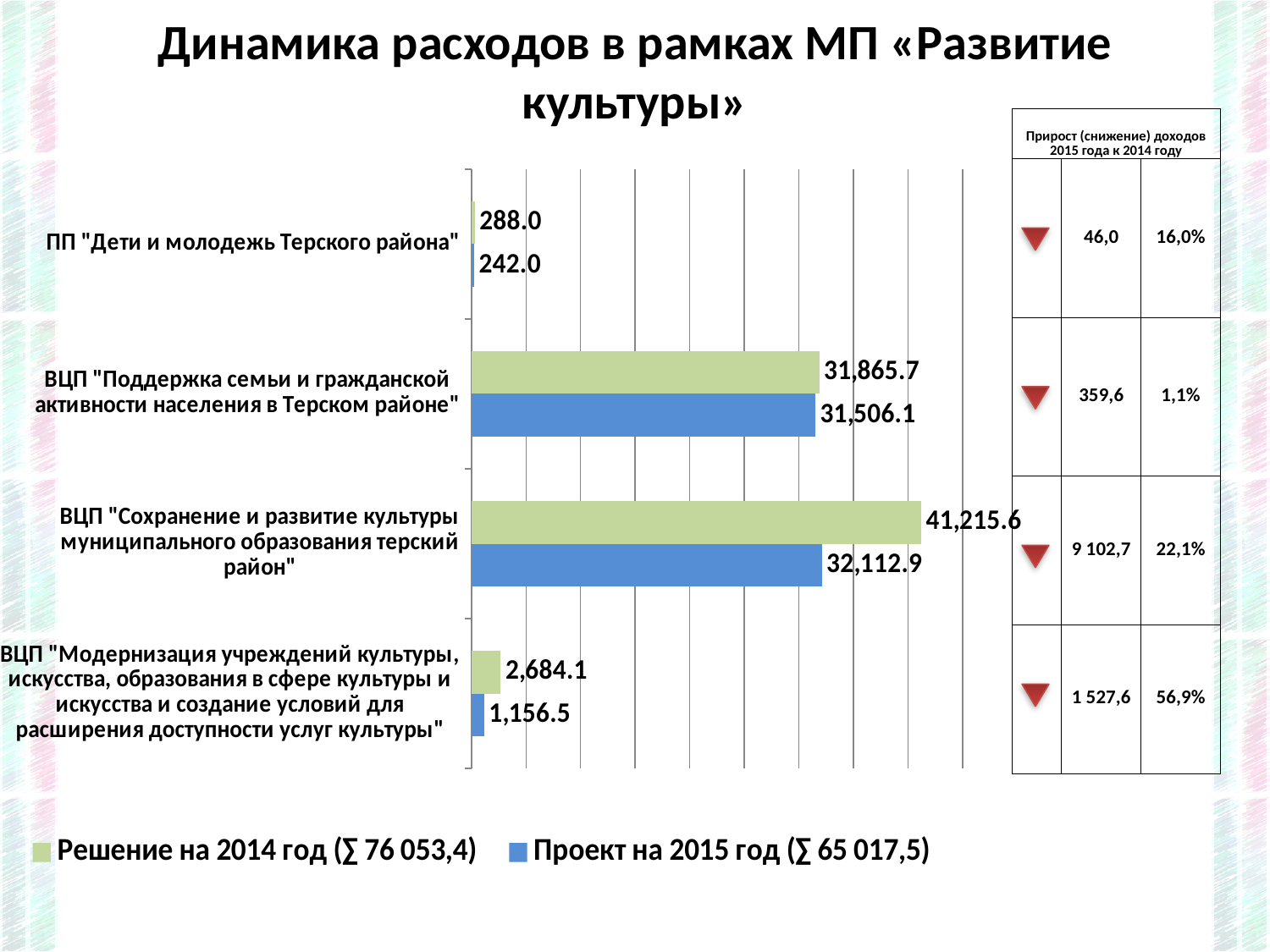
What is the value of "Проект на 2015 год" for ВЦП "Поддержка семьи и гражданской активности населения в Терском районе"? 31,506.1 What is the value of "Проект на 2015 год" for ПП "Дети и молодежь Терского района"? 242.0 How many categories (programmes) are plotted on the chart? 4 For ВЦП "Модернизация учреждений культуры...", which is larger: the "Решение на 2014 год" value or the "Проект на 2015 год" value? Решение на 2014 год What is the value of "Решение на 2014 год" for ВЦП "Модернизация учреждений культуры, искусства, образования в сфере культуры и искусства и создание условий для расширения доступности услуг культуры"? 2,684.1 What is the difference between the 2014 and 2015 values for ВЦП "Сохранение и развитие культуры муниципального образования терский район"? 9,102.7 Which category has the highest value for "Решение на 2014 год"? ВЦП "Сохранение и развитие культуры муниципального образования терский район" What is the value of "Решение на 2014 год" for ВЦП "Сохранение и развитие культуры муниципального образования терский район"? 41,215.6 Which category has the lowest value for "Проект на 2015 год"? ПП "Дети и молодежь Терского района" How many series does the chart legend list? 2 What total is shown in the legend entry for "Проект на 2015 год"? ∑ 65 017,5 What type of chart is shown on the slide? Bar chart